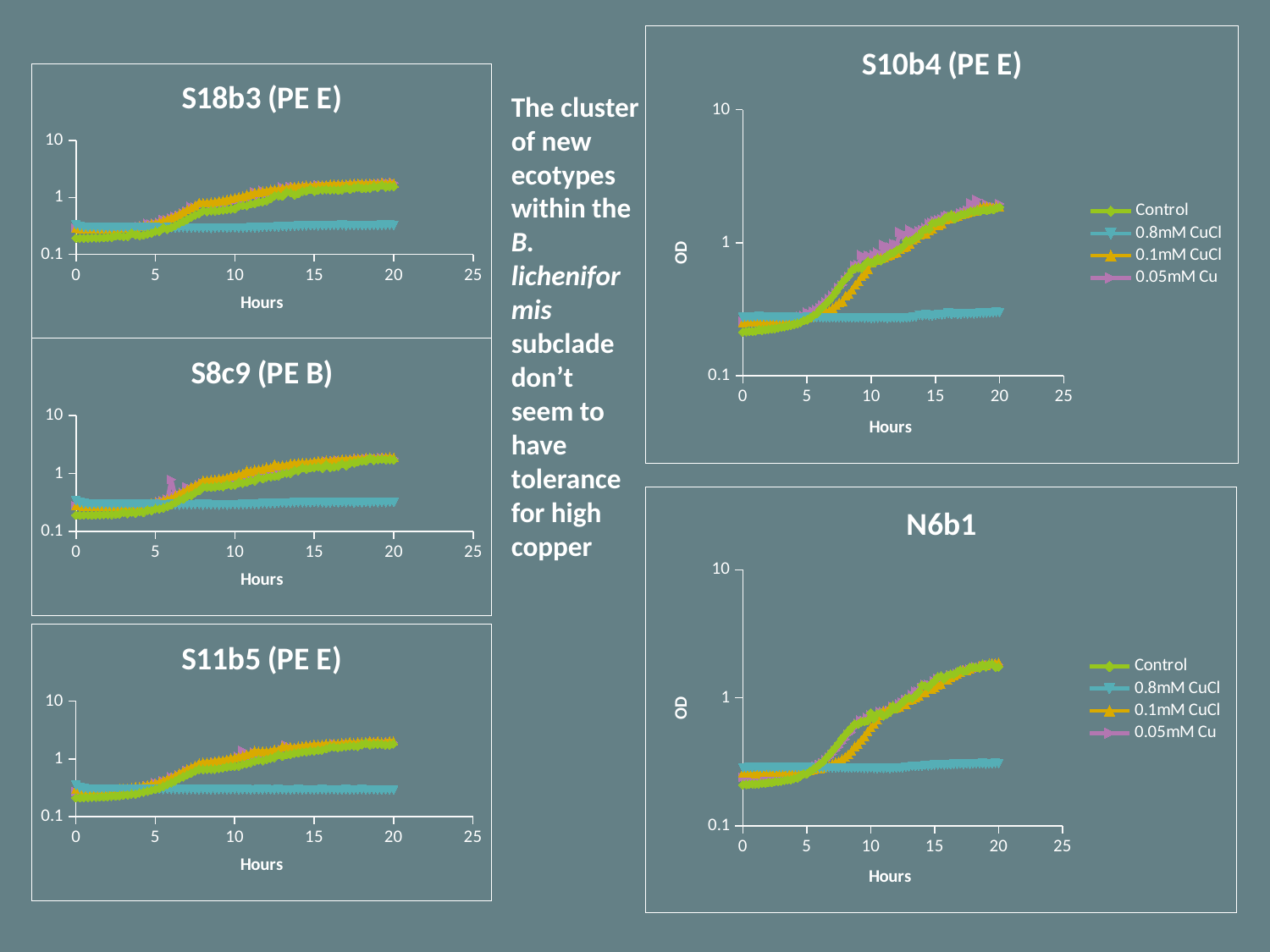
In the N6b1 chart, which is larger at 20 hours: the Control value or the 0.8mM CuCl value? Control In the N6b1 chart, does the Control series rise or fall as hours increase? rise In the N6b1 chart, is the 0.8mM CuCl value at 20 hours greater or less than 1? less In the S10b4 (PE E) chart, which series has the lowest value at 20 hours? 0.8mM CuCl What is the x-axis label of the S8c9 (PE B) chart? Hours In the S10b4 (PE E) chart, is the 0.8mM CuCl value at 20 hours greater or less than 1? less What is the y-axis label of the S10b4 (PE E) chart? OD How many charts are shown on the slide? 5 In the S10b4 (PE E) chart, is the Control value at 20 hours greater or less than 1? greater What kind of chart is the S10b4 (PE E) chart? line chart How many series does the legend of the N6b1 chart list? 4